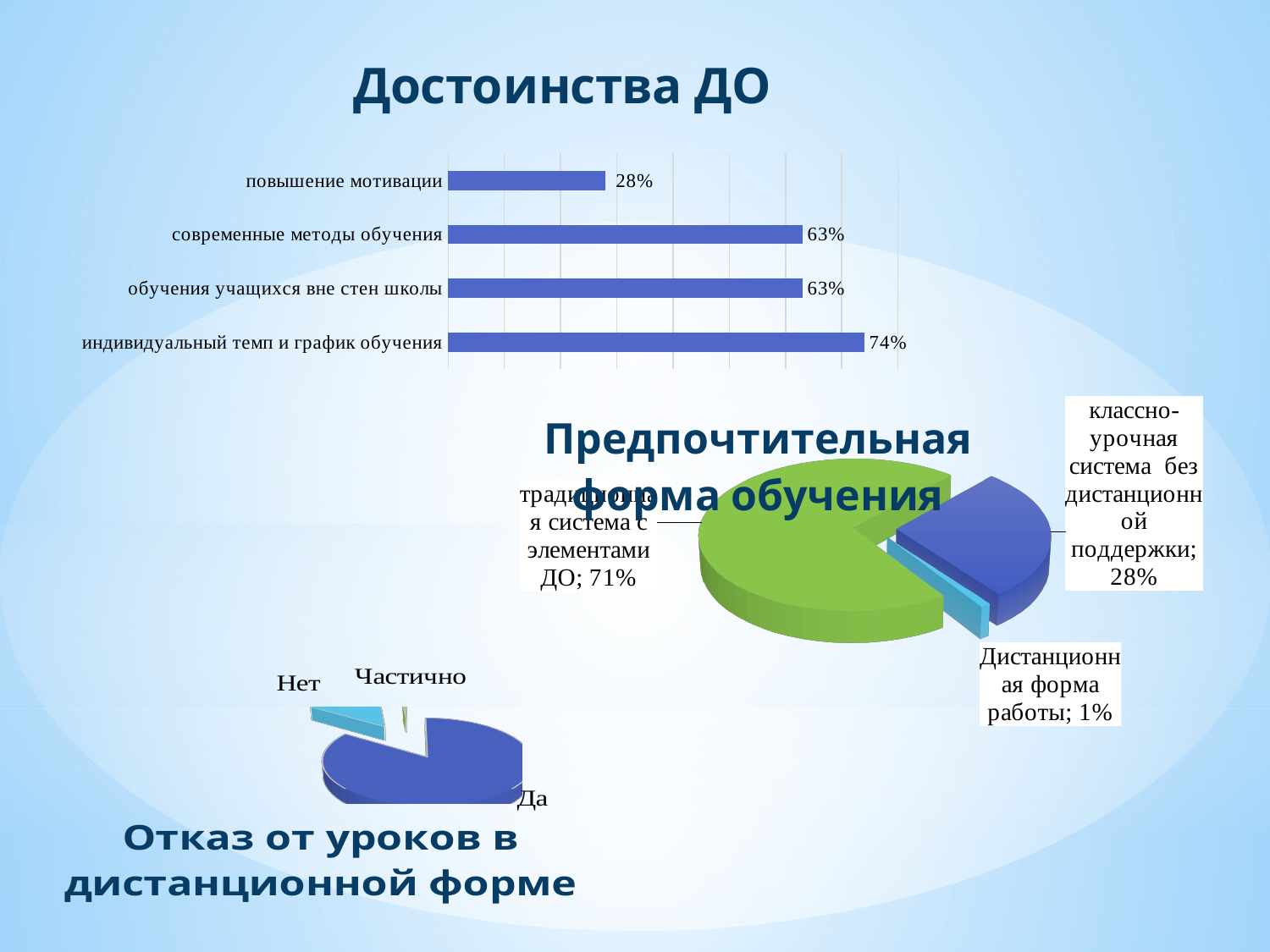
In the pie chart "Предпочтительная форма обучения", how many slices are there? 3 In the bar chart "Достоинства ДО", how many categories are shown? 4 In the pie chart "Предпочтительная форма обучения", what share is "традиционная система с элементами ДО"? 71% In the pie chart "Отказ от уроков в дистанционной форме", which slice is the largest? Да In the pie chart "Предпочтительная форма обучения", what share is "Дистанционная форма работы"? 1% In the bar chart "Достоинства ДО", what is the value for "индивидуальный темп и график обучения"? 74% What kind of chart is the chart titled "Достоинства ДО"? bar chart In the bar chart "Достоинства ДО", what is the difference between "индивидуальный темп и график обучения" and "повышение мотивации"? 46% In the bar chart "Достоинства ДО", what is the value for "повышение мотивации"? 28% In the bar chart "Достоинства ДО", which category has the lowest value? повышение мотивации In the bar chart "Достоинства ДО", which category has the highest value? индивидуальный темп и график обучения In the pie chart "Предпочтительная форма обучения", which slice is the largest? традиционная система с элементами ДО